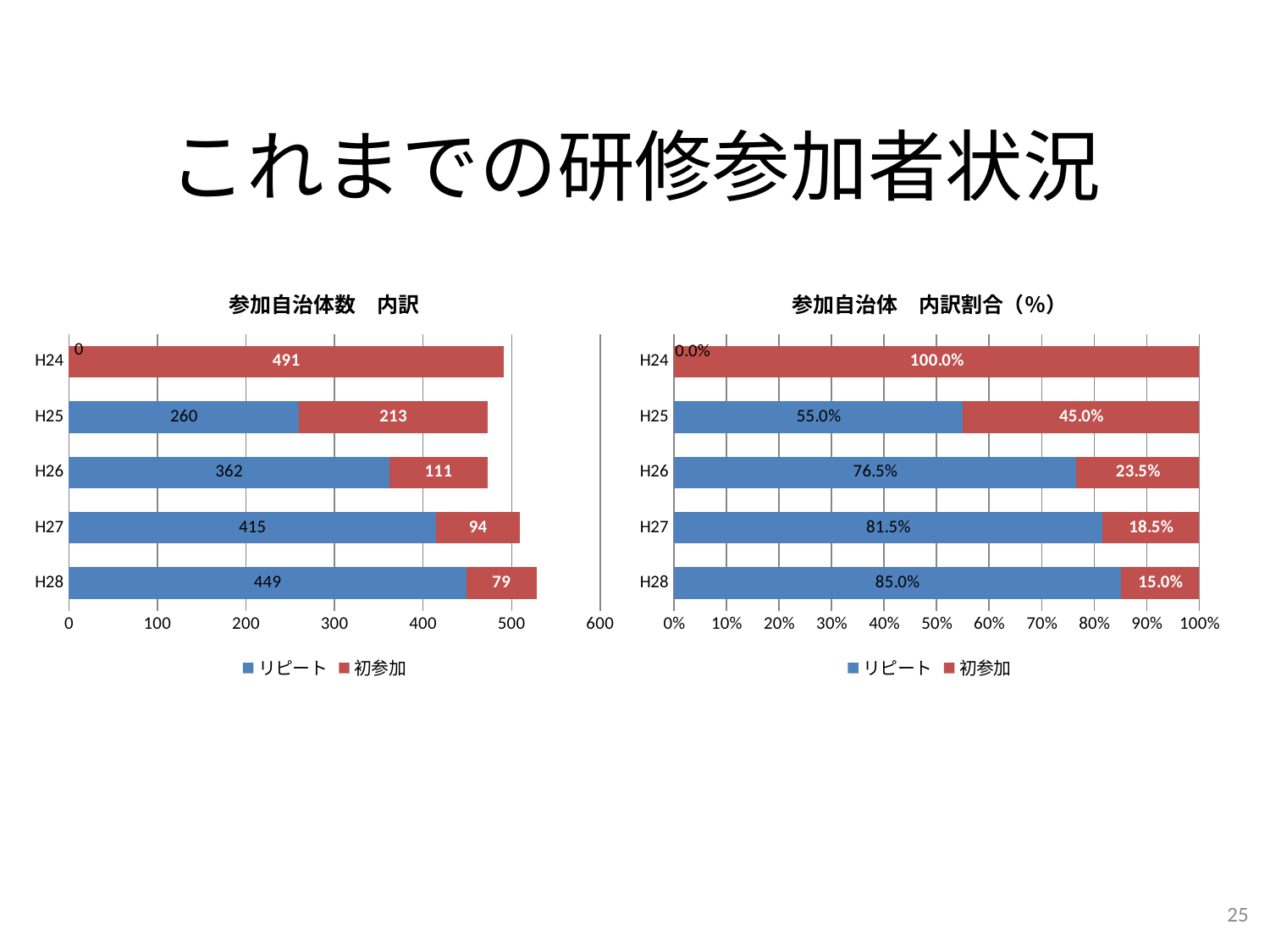
How many categories (years) are shown in the left chart (参加自治体数 内訳)? 5 In the left chart (参加自治体数 内訳), which year has the highest リピート value? H28 In the right chart (参加自治体 内訳割合（%）), what is the 初参加 share for H28? 15.0% In the left chart (参加自治体数 内訳), what is the difference between the リピート values for H28 and H25? 189 In the left chart (参加自治体数 内訳), what is the total of the stacked bar for H26? 473 In the left chart (参加自治体数 内訳), which is larger: the 初参加 value for H27 or the 初参加 value for H26? 初参加 for H26 In the right chart (参加自治体 内訳割合（%）), does the リピート share rise or fall from H24 to H28? rise In the left chart (参加自治体数 内訳), which year has the lowest 初参加 value? H28 In the left chart (参加自治体数 内訳), what is the 初参加 value for H25? 213 In the left chart (参加自治体数 内訳), what is the リピート value for H27? 415 How many series does the legend of the right chart (参加自治体 内訳割合（%）) list? 2 In the right chart (参加自治体 内訳割合（%）), what is the リピート share for H26? 76.5%